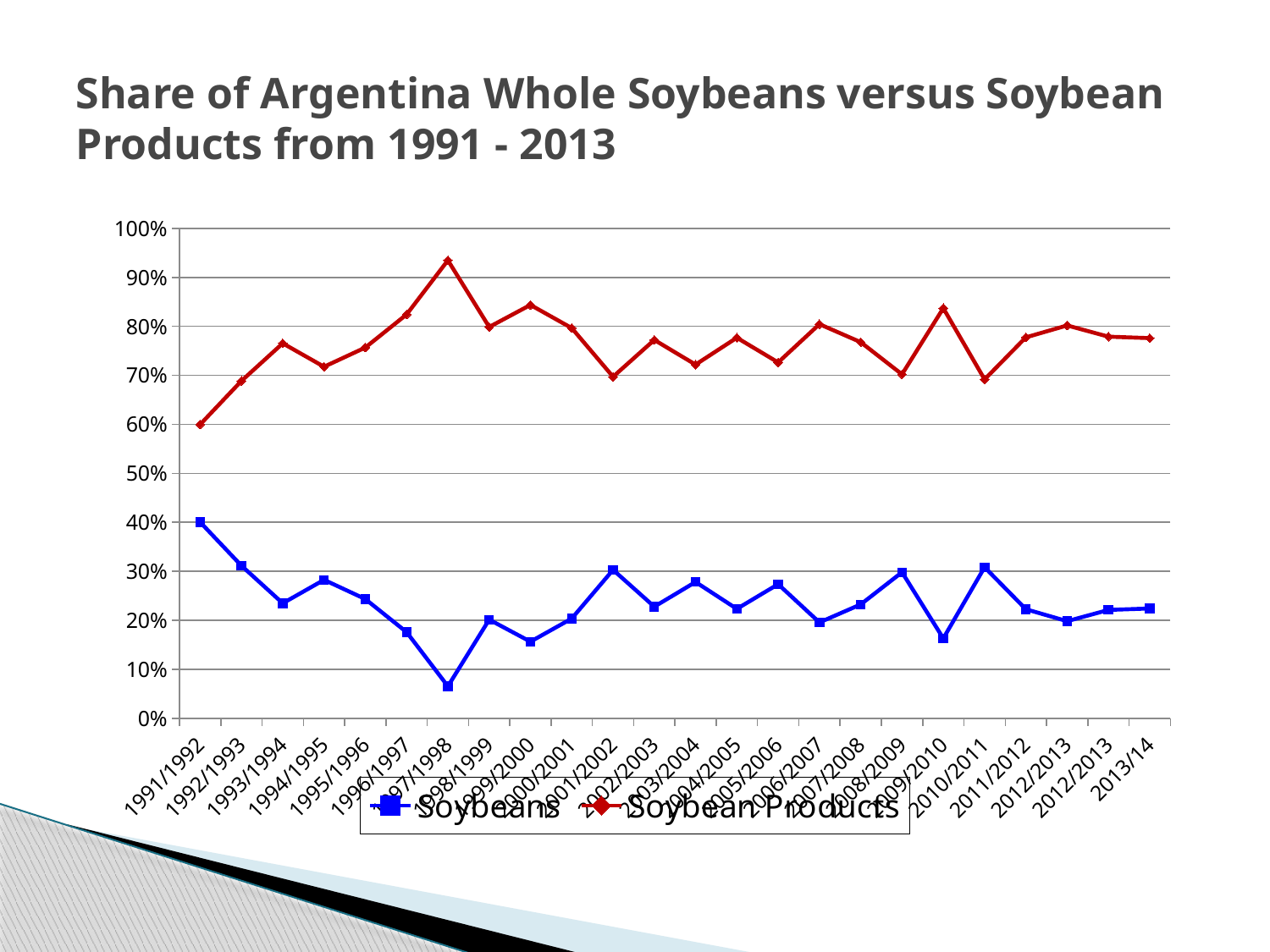
What are the two series named in the legend? Soybeans and Soybean Products In which season is the Soybeans series at its highest value? 1991/1992 In which season does the Soybeans series reach its lowest value? 1997/1998 How many series does the legend list? 2 Is the value for Soybean Products in 1997/1998 greater or less than 90%? greater In which season is the Soybean Products series at its lowest value? 1991/1992 Does the Soybeans series rise or fall from 1991/1992 to 1997/1998? fall In which season does the Soybean Products series reach its highest value? 1997/1998 What kind of chart is shown on the slide? line chart Which series has the larger value in 2009/2010, Soybeans or Soybean Products? Soybean Products What colour is the Soybean Products line? red Is the value for Soybeans in 1997/1998 greater or less than 10%? less